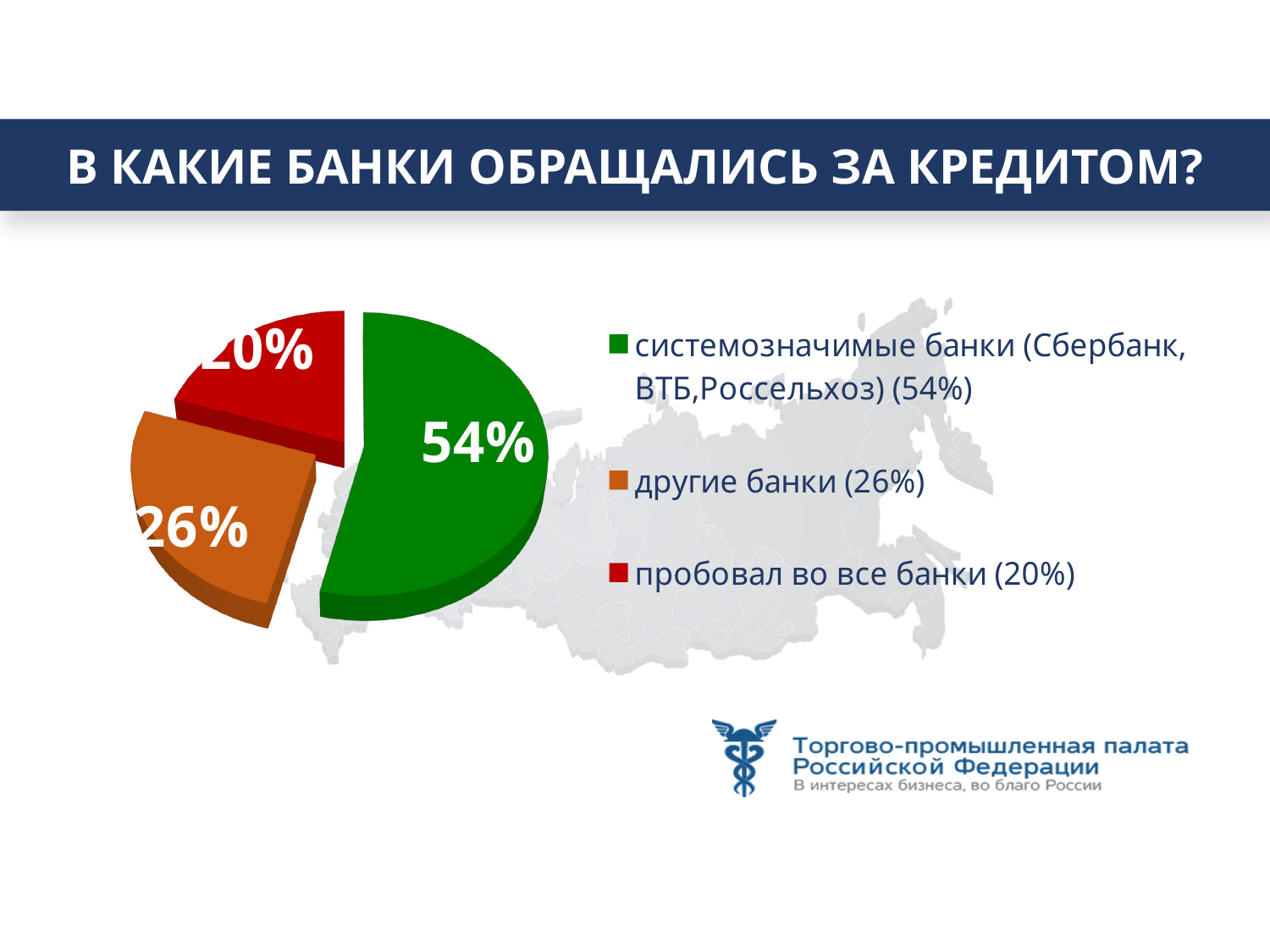
How many slices does the pie chart have? 3 Which category has the smallest slice of the pie? пробовал во все банки What is the difference in percentage points between the slice for системозначимые банки and the slice for другие банки? 28 Which slice is larger: другие банки or пробовал во все банки? другие банки What share of the pie is labelled for пробовал во все банки? 20% Which category has the largest slice of the pie? системозначимые банки (Сбербанк, ВТБ, Россельхоз) What share of the pie is labelled for другие банки? 26% What is the difference in percentage points between the slice for другие банки and the slice for пробовал во все банки? 6 What kind of chart is shown on the slide? Pie chart What is the title of the slide containing the pie chart? В КАКИЕ БАНКИ ОБРАЩАЛИСЬ ЗА КРЕДИТОМ? What colour is the slice for другие банки in the pie chart? Orange What share of the pie is labelled for системозначимые банки (Сбербанк, ВТБ, Россельхоз)? 54%